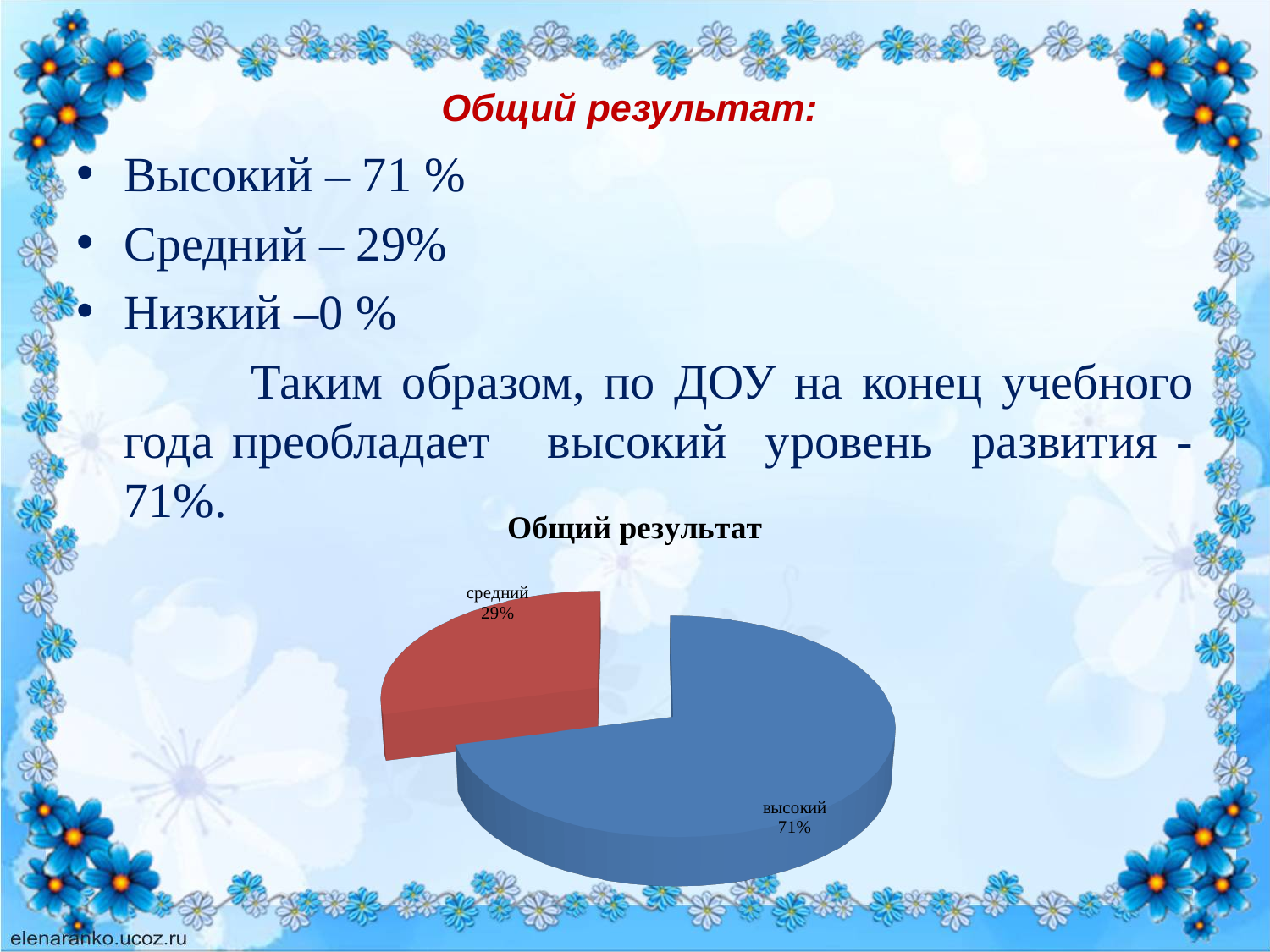
What is the combined share of the "высокий" and "средний" slices? 100% Which slice of the pie is the largest? высокий What share of the pie does the "высокий" slice represent? 71% What is the title of the chart? Общий результат How many slices does the pie chart have? 2 What colour is the "высокий" slice? blue Which slice of the pie is the smallest? средний What share of the pie does the "средний" slice represent? 29% What kind of chart is shown on the slide? pie chart What is the difference in percentage points between the "высокий" and "средний" slices? 42 Which is larger, the "высокий" slice or the "средний" slice? высокий